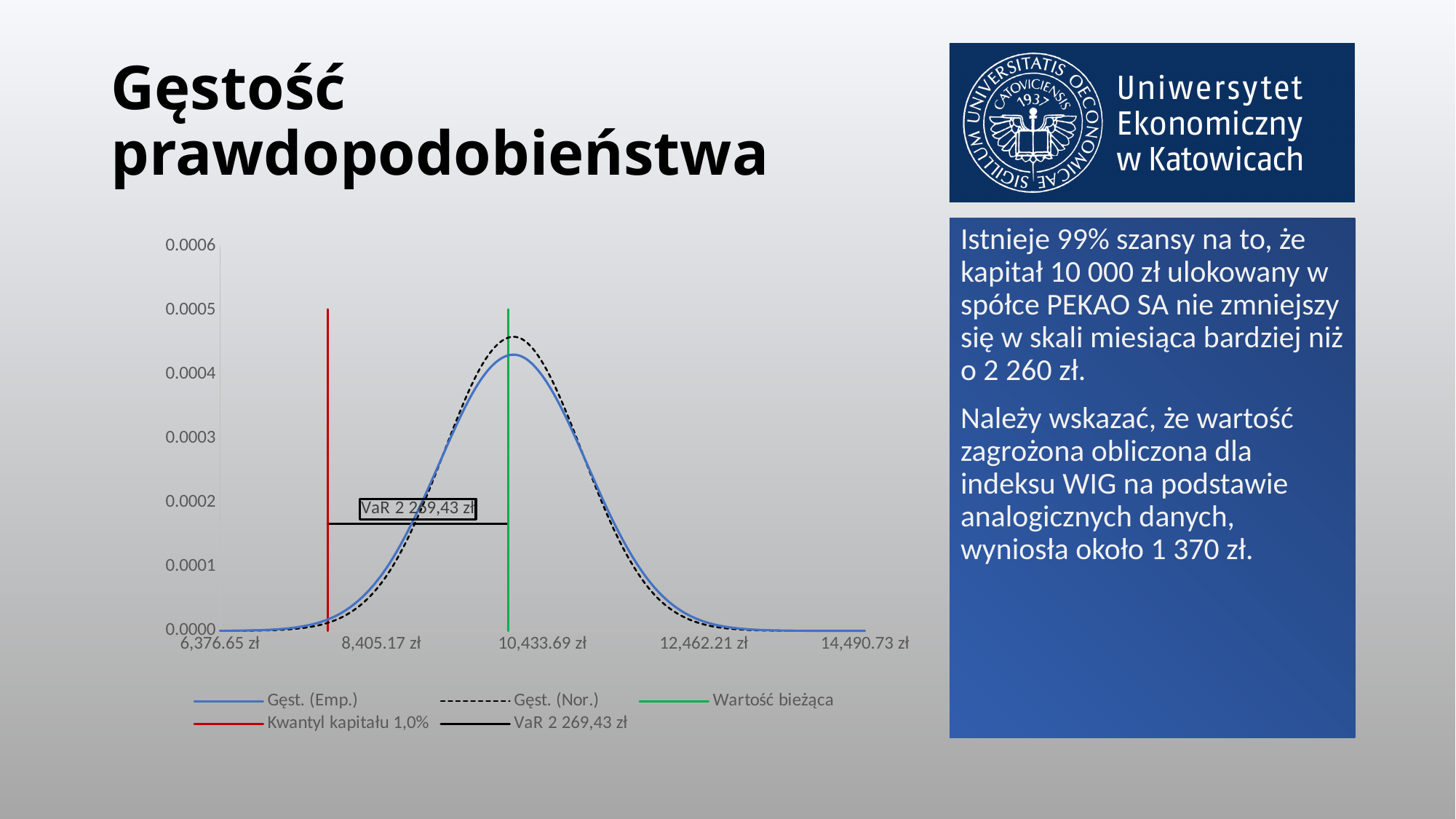
Is the peak value of the Gęst. (Nor.) curve greater or less than 0.0004? greater Is the Wartość bieżąca line positioned at a value greater or less than 8,405.17 zł on the x axis? greater Is the peak value of the Gęst. (Emp.) curve greater or less than 0.0005? less Which curve reaches a higher peak, Gęst. (Nor.) or Gęst. (Emp.)? Gęst. (Nor.) Which legend series is drawn as a green vertical line? Wartość bieżąca Which legend series is drawn as a red vertical line? Kwantyl kapitału 1,0% Does the Gęst. (Emp.) curve rise or fall between 8,405.17 zł and 10,433.69 zł on the x axis? rise What VaR value is given in the chart legend? 2 269,43 zł How many series does the chart legend list? 5 What kind of chart is shown on the slide? line chart How many labelled tick values are shown on the x axis? 5